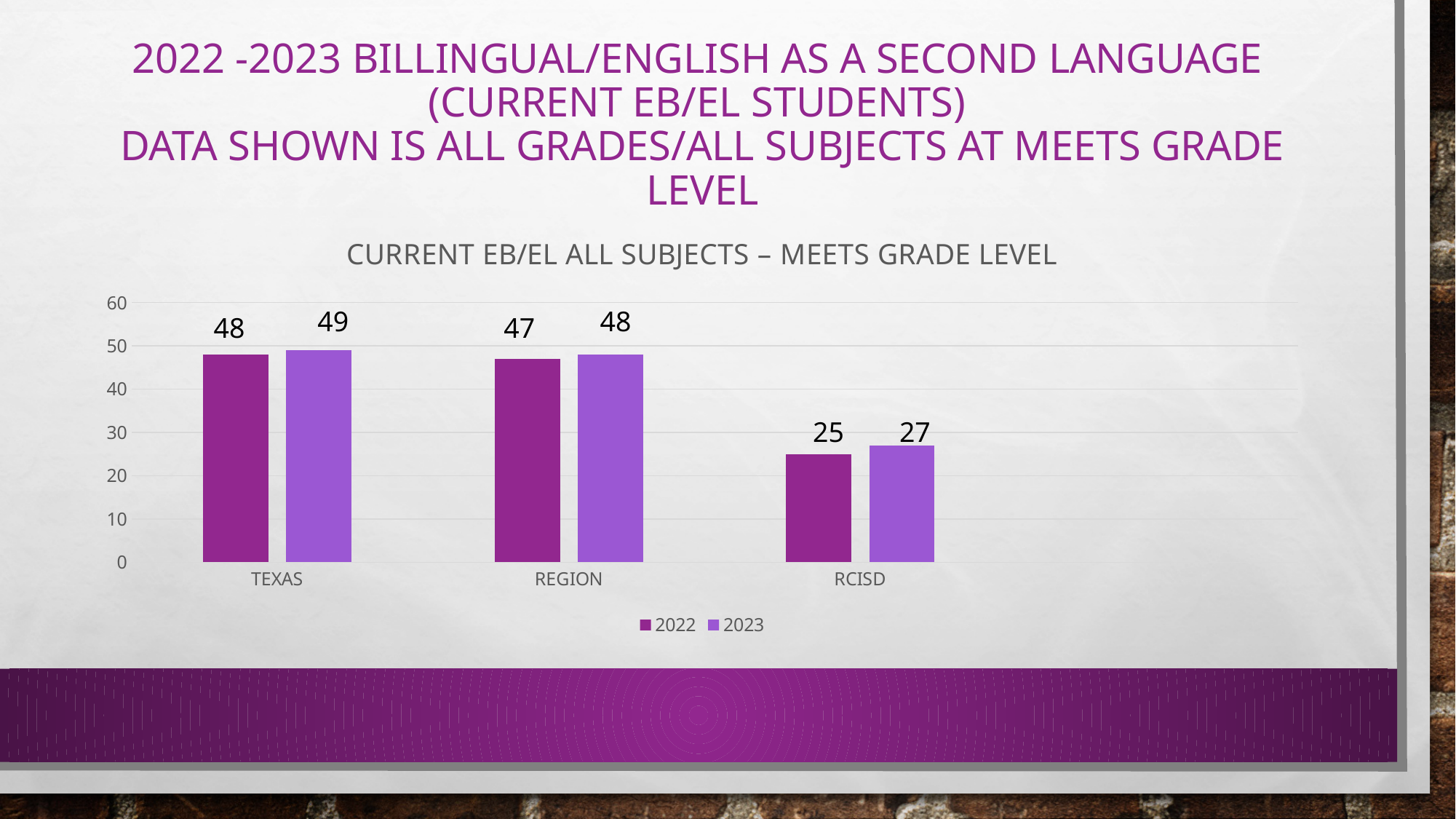
How many categories are shown on the x axis? 3 What is the 2022 value for Region? 47 Which category has the lowest 2023 value? RCISD What is the 2022 value for Texas? 48 What kind of chart is shown? bar chart What is the 2023 value for RCISD? 27 Which category has the highest 2023 value? Texas What is the difference between the 2023 and 2022 values for RCISD? 2 Is the 2022 value for Region larger or the 2022 value for RCISD? Region Is the 2023 value for RCISD greater or less than 30? less What is the difference between the 2022 values for Texas and RCISD? 23 How many series does the legend list? 2